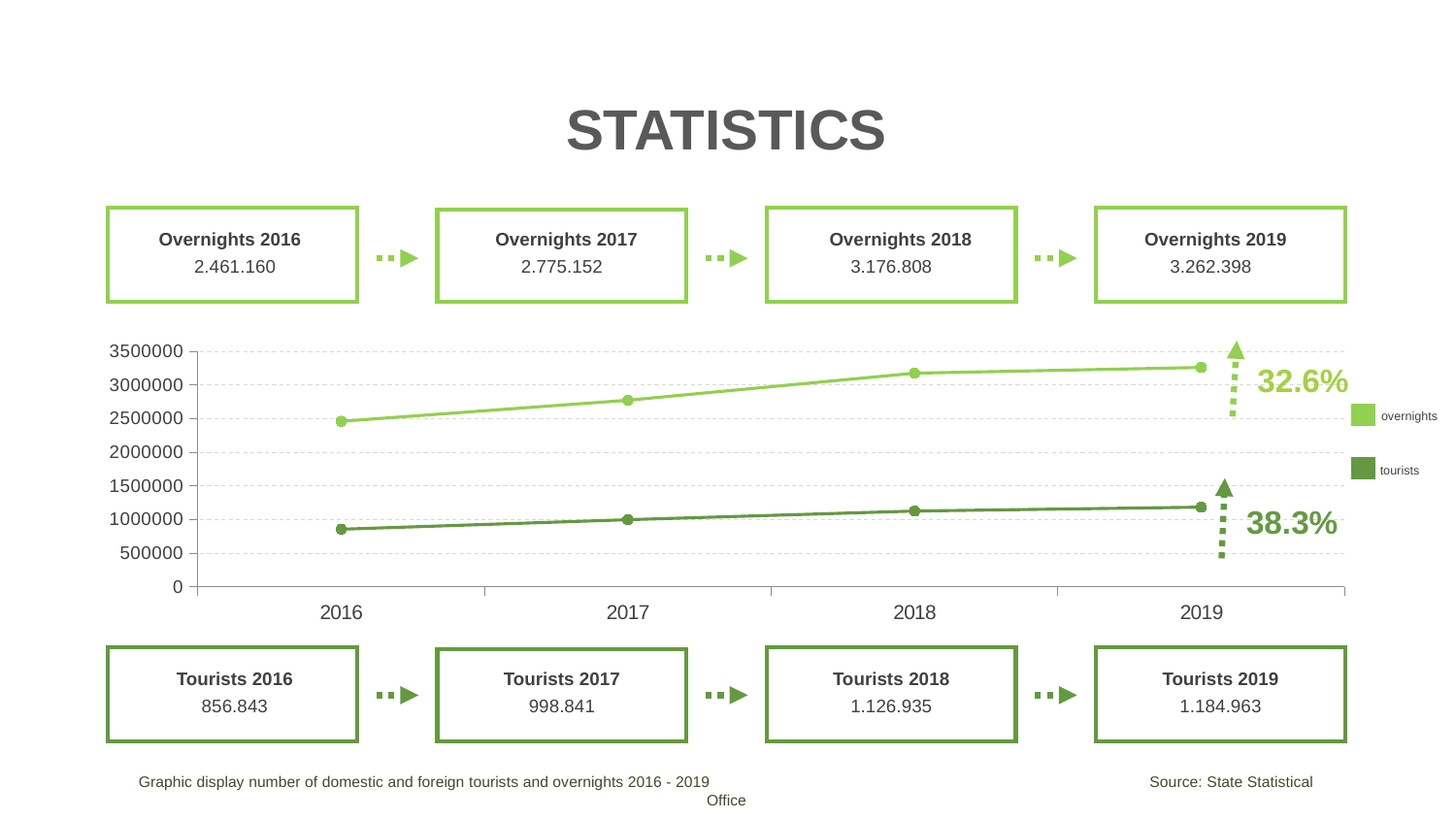
Which is larger, overnights in 2017 or tourists in 2018? Overnights in 2017 What is the value for tourists in 2017? 998.841 What is the value for overnights in 2018? 3.176.808 What is the value for tourists in 2019? 1.184.963 What kind of chart is shown on the slide? Line chart In which year is the tourists series lowest? 2016 In which year is the overnights series highest? 2019 What is the difference between tourists in 2019 and tourists in 2016? 328.120 What is the value for overnights in 2016? 2.461.160 How many series does the legend list? 2 Is the value for tourists in 2018 greater or less than 1000000? greater What is the difference between overnights in 2019 and overnights in 2016? 801.238